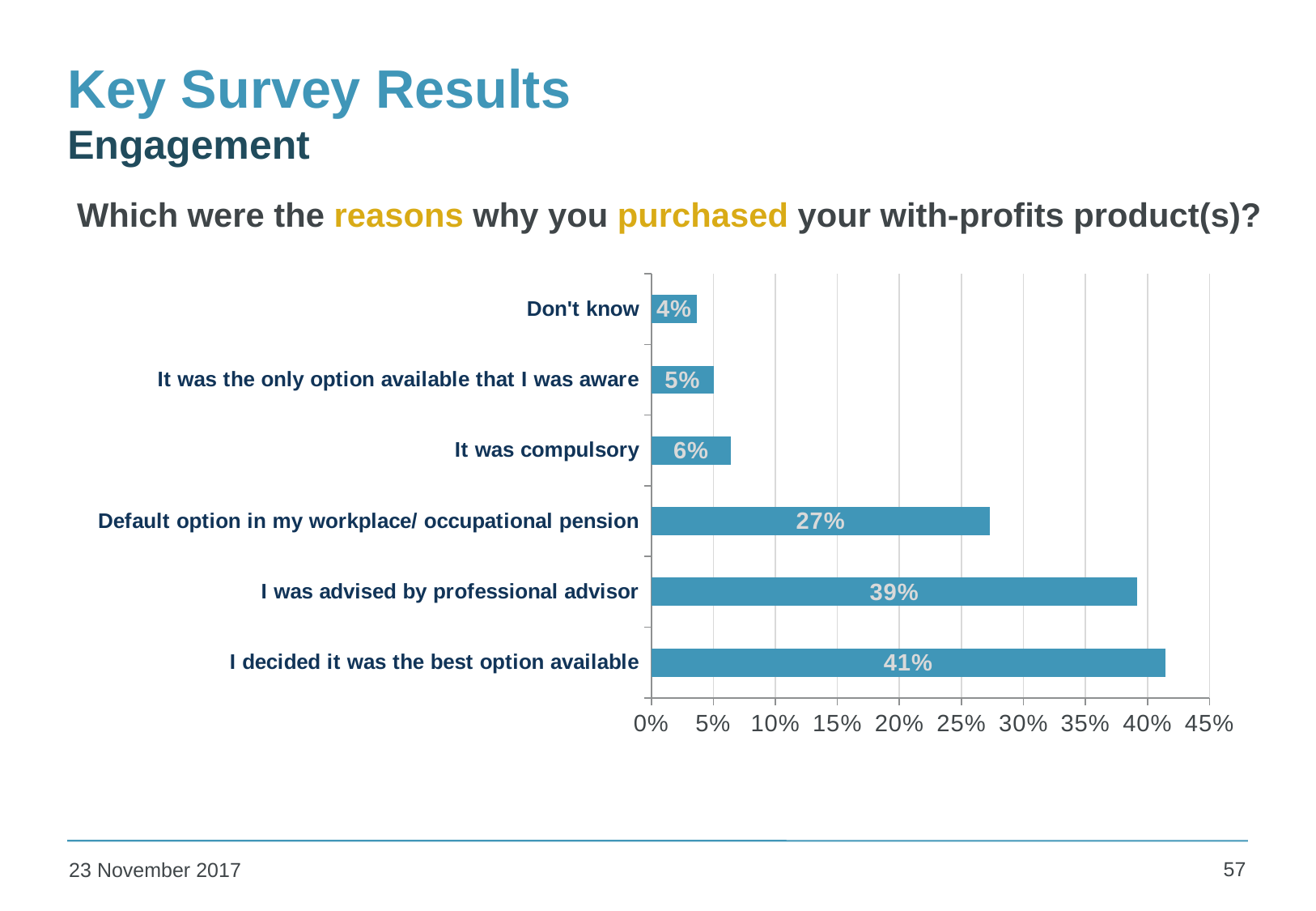
What is the maximum value shown on the x axis? 45% What percentage of respondents said they were advised by a professional advisor? 39% Which reason has the lowest percentage? Don't know What is the value for 'Default option in my workplace/ occupational pension'? 27% Which is larger: 'It was compulsory' or 'It was the only option available that I was aware'? It was compulsory Which reason has the highest percentage? I decided it was the best option available What percentage of respondents answered 'Don't know'? 4% Is the value for 'Default option in my workplace/ occupational pension' greater or less than 25%? greater What is the difference in percentage points between 'I was advised by professional advisor' and 'Default option in my workplace/ occupational pension'? 12 percentage points How many reasons are shown in the chart? 6 What percentage of respondents said they decided it was the best option available? 41% What type of chart is shown on the slide? Bar chart